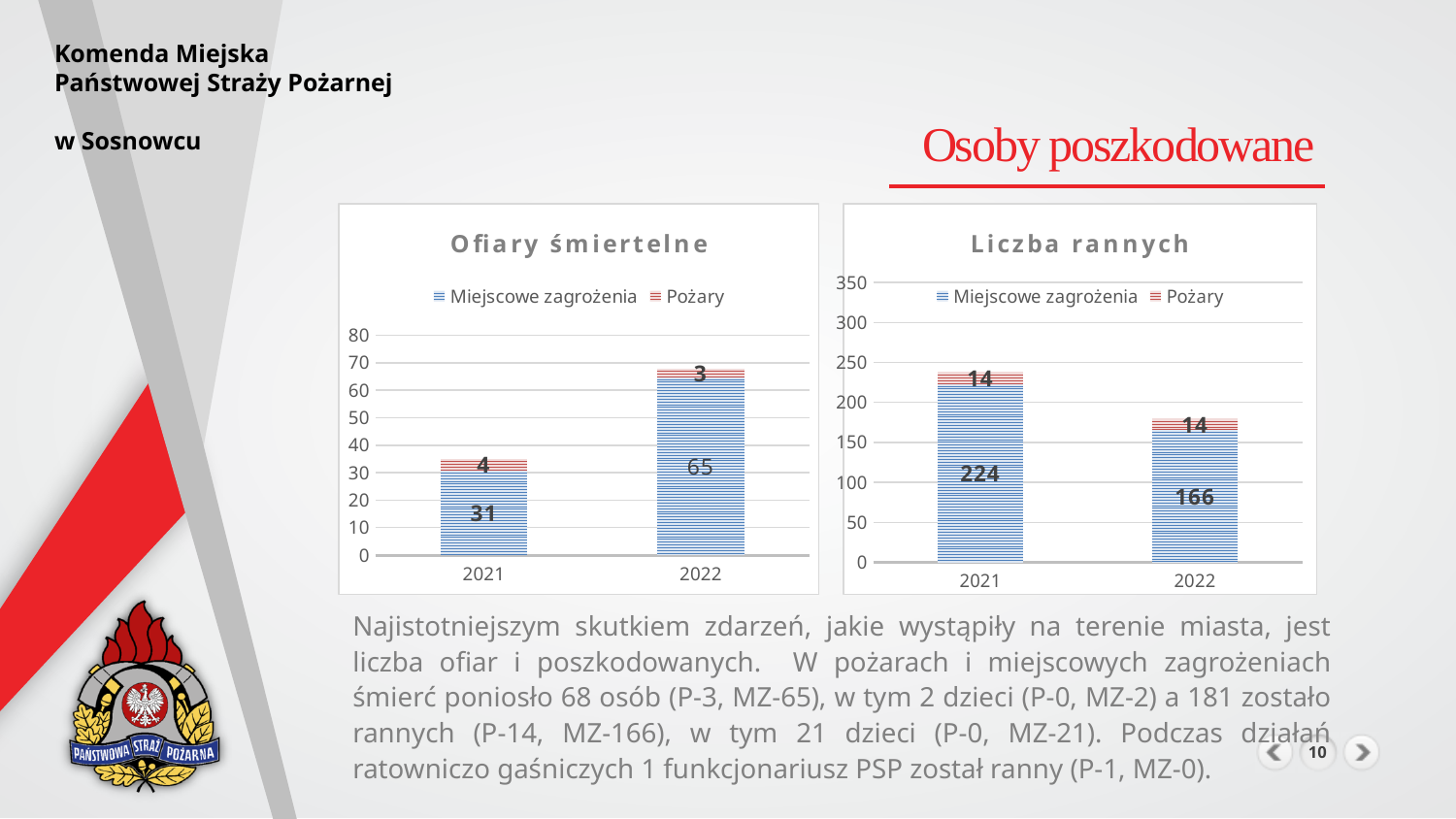
In the 'Liczba rannych' chart, what is the value for Miejscowe zagrożenia in 2021? 224 In the 'Liczba rannych' chart, does the Miejscowe zagrożenia value rise or fall from 2021 to 2022? fall What kind of chart is the 'Liczba rannych' chart? stacked bar chart In the 'Liczba rannych' chart, what is the total of the stacked bar for 2021? 238 How many categories are shown on the x axis of the 'Liczba rannych' chart? 2 In the 'Liczba rannych' chart, what is the value for Pożary in 2022? 14 In the 'Ofiary śmiertelne' chart, what is the value for Pożary in 2021? 4 In the 'Ofiary śmiertelne' chart, which year has the higher Miejscowe zagrożenia value, 2021 or 2022? 2022 In the 'Liczba rannych' chart, what is the difference between the Miejscowe zagrożenia values for 2021 and 2022? 58 How many series does the legend of the 'Ofiary śmiertelne' chart list? 2 In the 'Ofiary śmiertelne' chart, what is the total of the stacked bar for 2022? 68 In the 'Ofiary śmiertelne' chart, what is the value for Miejscowe zagrożenia in 2022? 65